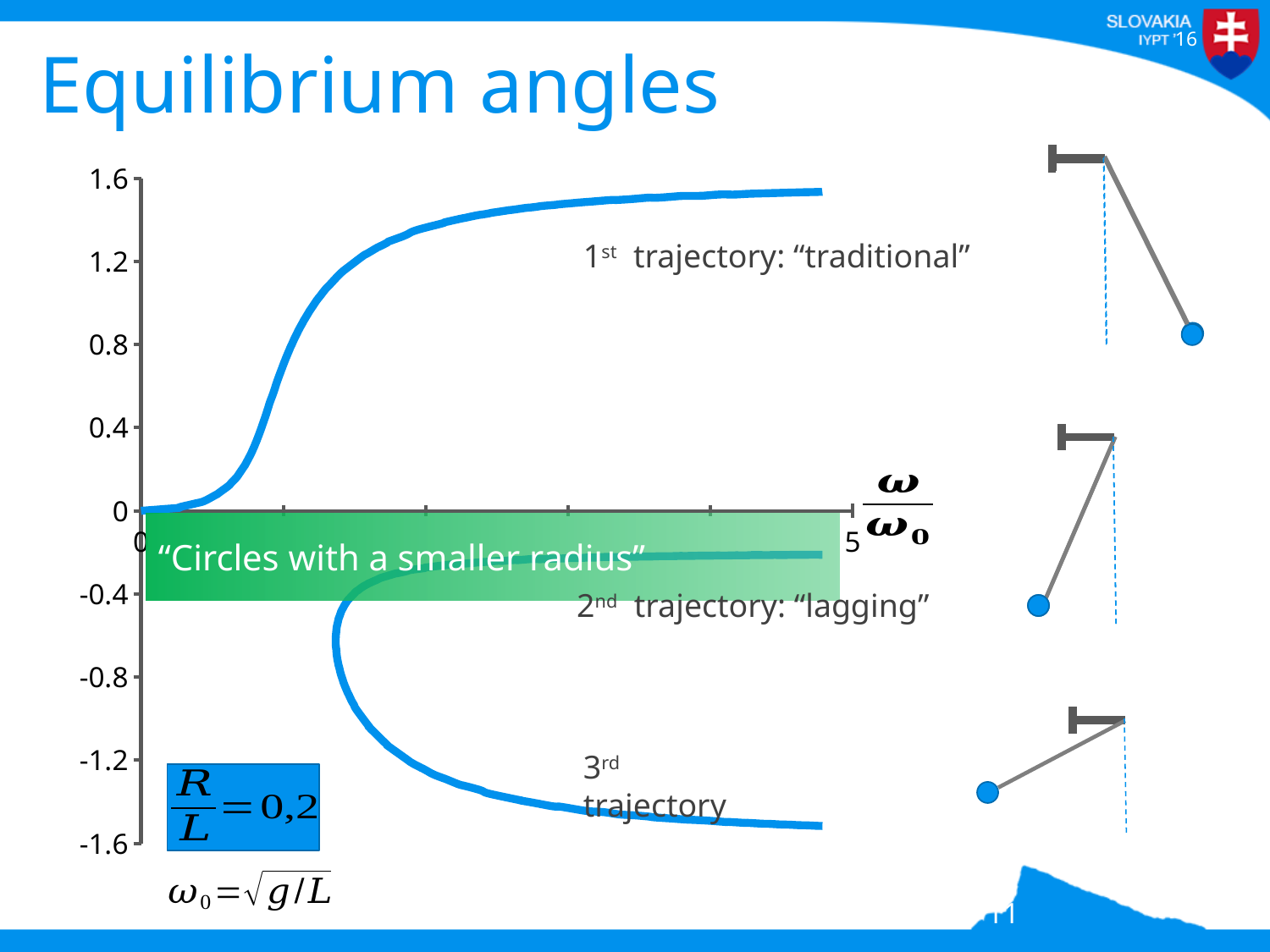
Is the value of the 1st trajectory ("traditional") at ω/ω0 = 1 greater or less than 0.4? greater At ω/ω0 = 5, which is larger: the value of the 1st trajectory ("traditional") or the value of the 2nd trajectory ("lagging")? 1st trajectory: "traditional" What kind of chart is shown on the slide? line chart What is the maximum value shown on the y axis of the chart? 1.6 Is the value of the 1st trajectory ("traditional") at ω/ω0 = 5 greater or less than 1.2? greater Does the 1st trajectory ("traditional") rise or fall as ω/ω0 increases? rise What is the title of the slide containing the chart? Equilibrium angles Is the value of the 3rd trajectory at ω/ω0 = 5 greater or less than -1.2? less Which trajectory has the highest values on the chart: the 1st ("traditional"), the 2nd ("lagging") or the 3rd? 1st trajectory: "traditional" How many trajectories are plotted on the chart? 3 Which trajectory has the lowest values on the chart: the 1st ("traditional"), the 2nd ("lagging") or the 3rd? 3rd trajectory What quantity is shown on the x axis of the chart? ω/ω0